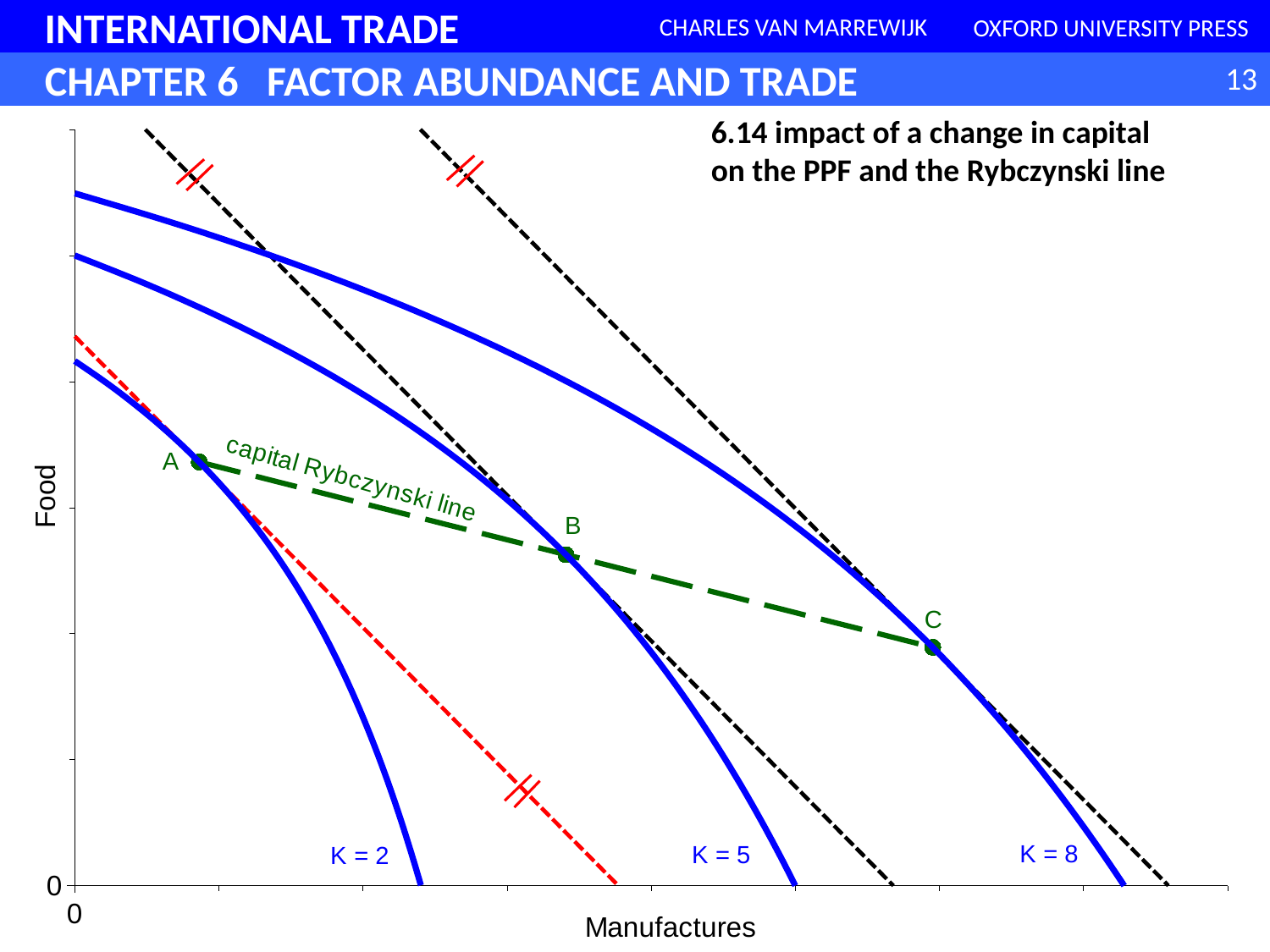
Which labelled point has the lowest quantity of Food? C How many blue PPF curves are drawn on the chart? 3 Which labelled point (A, B or C) lies on the PPF for K = 5? B What capital level is labelled on the innermost (leftmost) blue PPF curve? K = 2 What capital level is labelled on the outermost (rightmost) blue PPF curve? K = 8 What is the title of the chart on the slide? 6.14 impact of a change in capital on the PPF and the Rybczynski line How many labelled points (A, B, C) are marked on the capital Rybczynski line? 3 What label is on the vertical axis of the chart? Food Which labelled point has the highest quantity of Manufactures? C What value is printed at the origin of the horizontal axis? 0 Which point has more Food, A or C? A Along the capital Rybczynski line, does Food rise or fall as Manufactures increases? fall